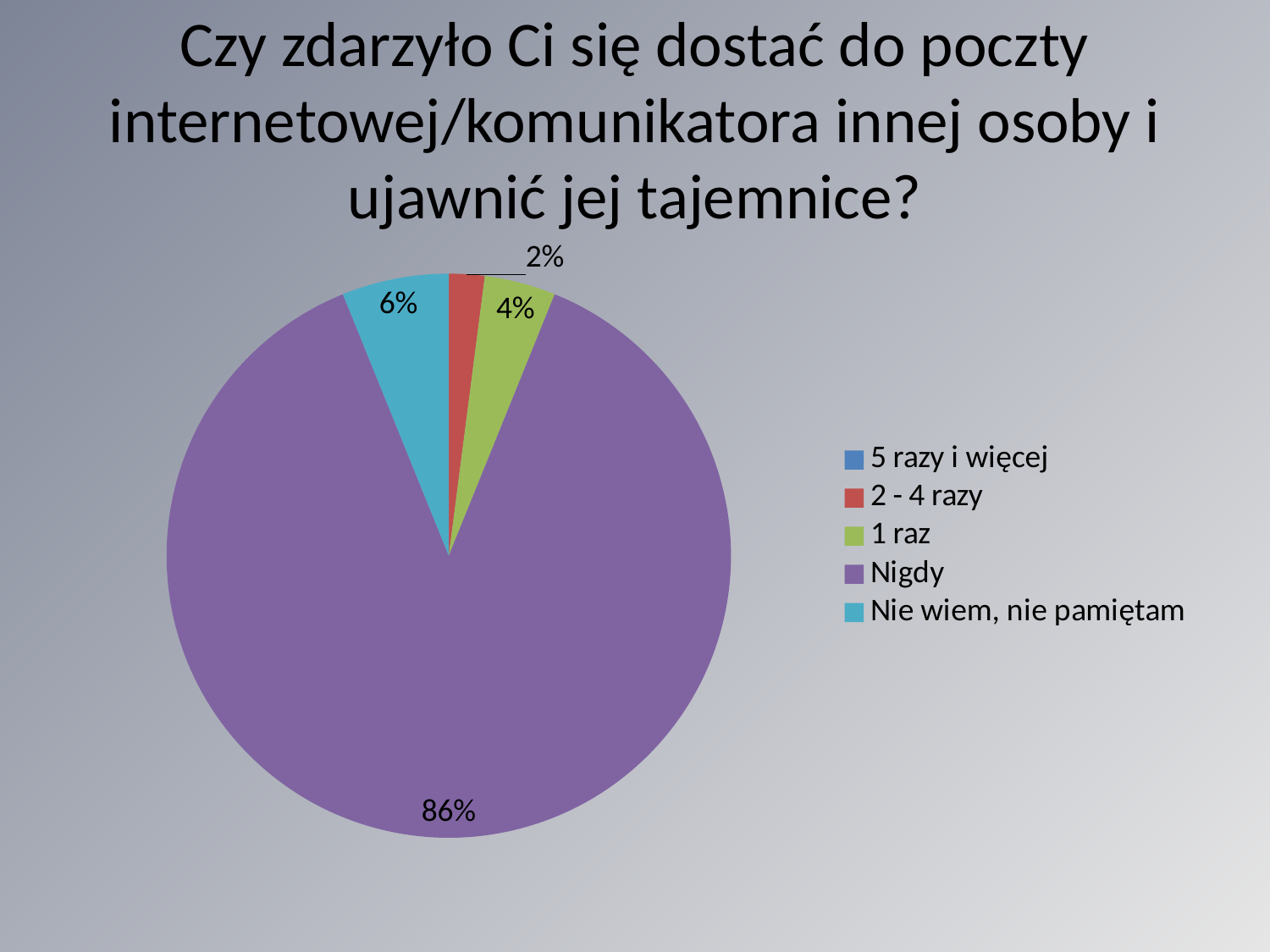
Which colour represents "Nigdy" in the pie chart? purple What percentage of respondents answered "Nigdy"? 86% What percentage of respondents answered "1 raz"? 4% Which is larger, the share for "1 raz" or the share for "2 - 4 razy"? 1 raz What is the difference in percentage points between "Nigdy" and "Nie wiem, nie pamiętam"? 80 What is the difference in percentage points between "Nie wiem, nie pamiętam" and "1 raz"? 2 What percentage of respondents answered "2 - 4 razy"? 2% Which legend entry is shown in light blue? Nie wiem, nie pamiętam Which answer has the largest share of the pie? Nigdy What percentage of respondents answered "Nie wiem, nie pamiętam"? 6% How many categories does the legend list? 5 What kind of chart is shown on the slide? pie chart